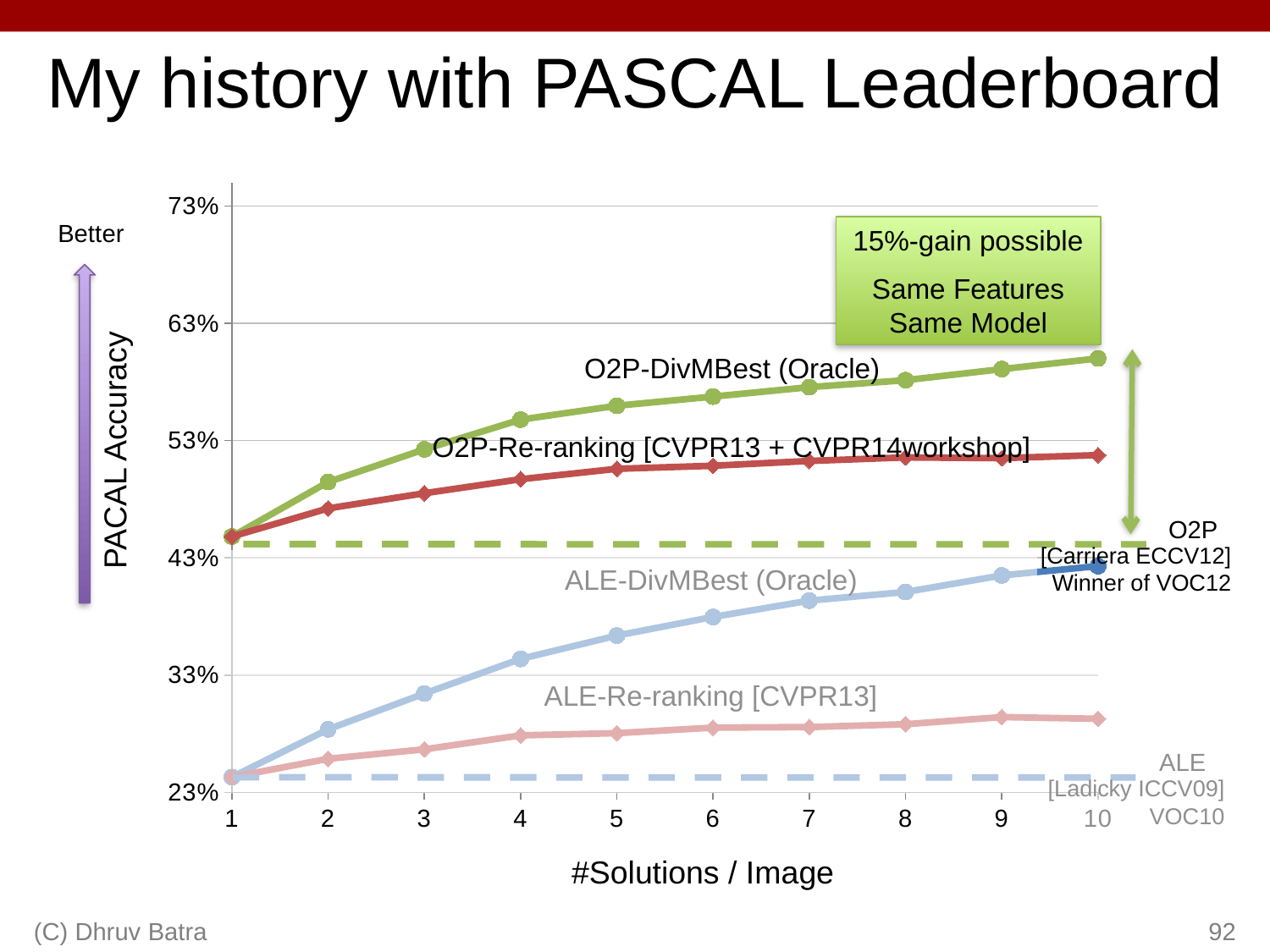
Is the value for O2P-Re-ranking at 1 solution per image greater or less than 43%? greater Is the value for ALE-Re-ranking [CVPR13] at 10 solutions per image greater or less than 33%? less Which line has the highest PASCAL accuracy at 10 solutions per image? O2P-DivMBest (Oracle) How many values of #Solutions / Image are shown on the x axis? 10 Does the ALE-DivMBest (Oracle) line rise or fall as #Solutions / Image increases? rise Is the value for ALE-DivMBest (Oracle) at 5 solutions per image greater or less than 33%? greater Does the O2P-DivMBest (Oracle) line rise or fall as #Solutions / Image increases? rise What is the title of the slide containing the chart? My history with PASCAL Leaderboard What kind of chart is shown on the slide? line chart At 10 solutions per image, which is larger: O2P-DivMBest (Oracle) or O2P-Re-ranking? O2P-DivMBest (Oracle) What is the label of the x axis of the chart? #Solutions / Image